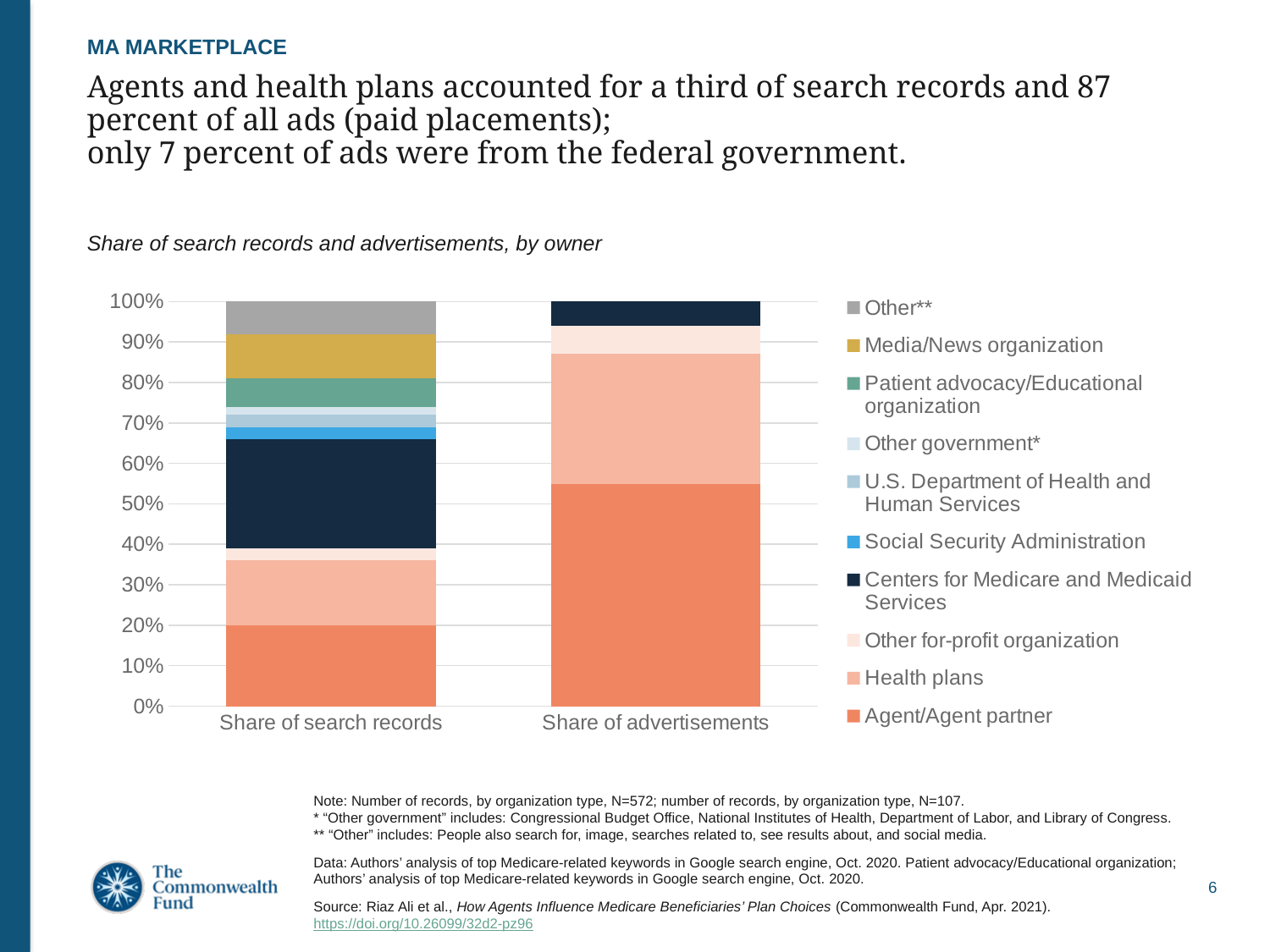
Is the Health plans share in the Share of advertisements bar greater or less than 20%? greater How many bars (categories) are plotted on the x axis? 2 Which series has the largest segment in the Share of advertisements bar? Agent/Agent partner How many series does the legend list? 10 Which series is listed at the bottom of the legend? Agent/Agent partner What kind of chart is shown on the slide? Stacked bar chart Is the Agent/Agent partner share larger in the Share of search records bar or the Share of advertisements bar? Share of advertisements What is the total height of the Share of advertisements stacked bar? 100% What is the title of the chart? Share of search records and advertisements, by owner Is the Agent/Agent partner share in the Share of advertisements bar greater or less than 50%? greater Is the Agent/Agent partner share in the Share of search records bar greater or less than 30%? less Which series has the largest segment in the Share of search records bar? Centers for Medicare and Medicaid Services